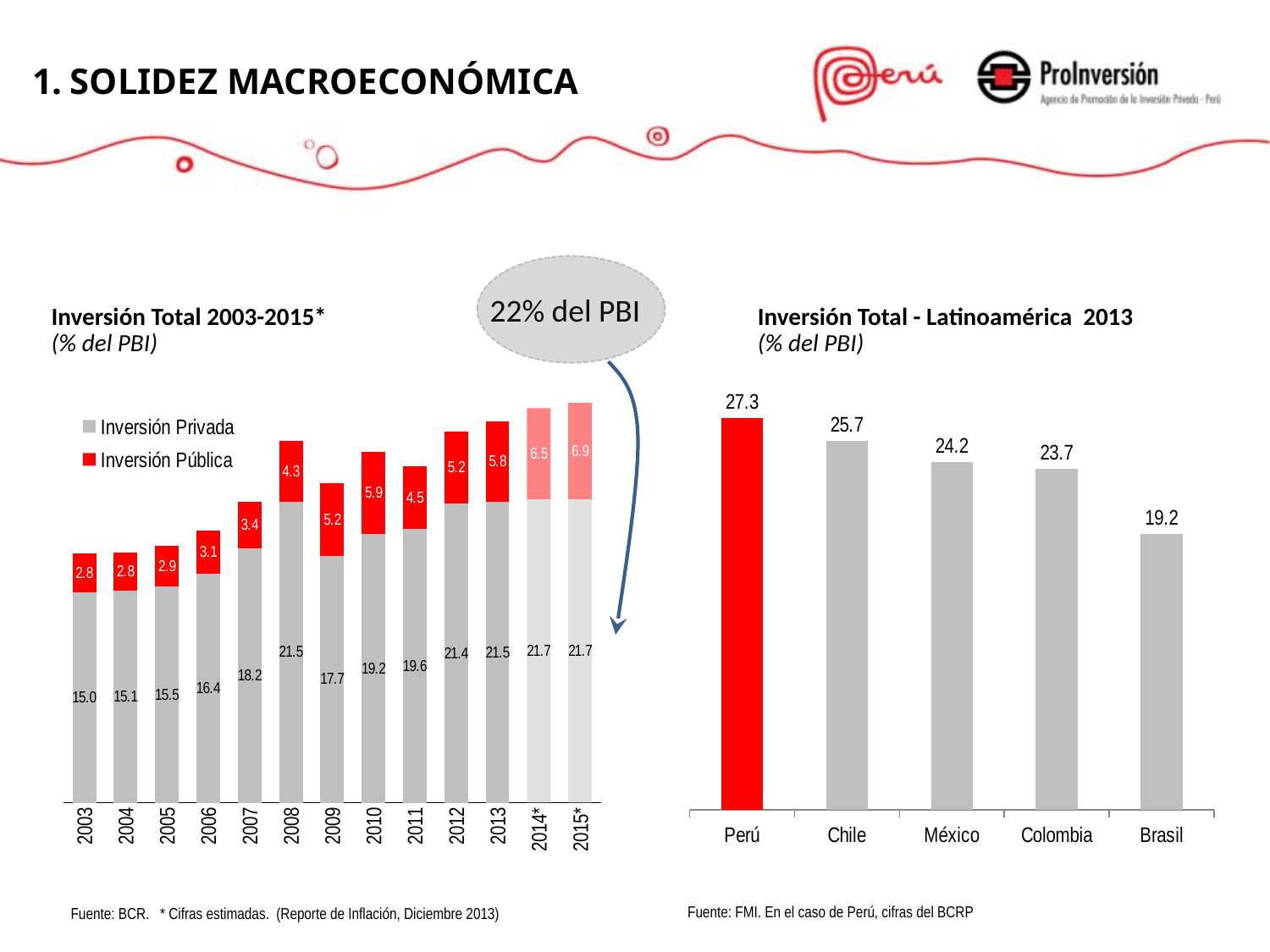
In the 'Inversión Total - Latinoamérica 2013' chart, what is the difference between Perú and Brasil? 8.1 In the 'Inversión Total 2003-2015*' chart, how many series does the legend list? 2 In the 'Inversión Total 2003-2015*' chart, which year has the highest Inversión Pública value? 2015* In the 'Inversión Total - Latinoamérica 2013' chart, which is larger, Chile or México? Chile In the 'Inversión Total - Latinoamérica 2013' chart, which country has the lowest value? Brasil In the 'Inversión Total 2003-2015*' chart, what is the Inversión Privada value for 2008? 21.5 What kind of chart is 'Inversión Total - Latinoamérica 2013'? Bar chart In the 'Inversión Total 2003-2015*' chart, what is the total of the stacked bar for 2015*? 28.6 In the 'Inversión Total 2003-2015*' chart, which year has the lowest Inversión Privada value? 2003 In the 'Inversión Total - Latinoamérica 2013' chart, what is the value for Colombia? 23.7 In the 'Inversión Total 2003-2015*' chart, how many years are shown on the x axis? 13 In the 'Inversión Total 2003-2015*' chart, what is the Inversión Pública value for 2010? 5.9